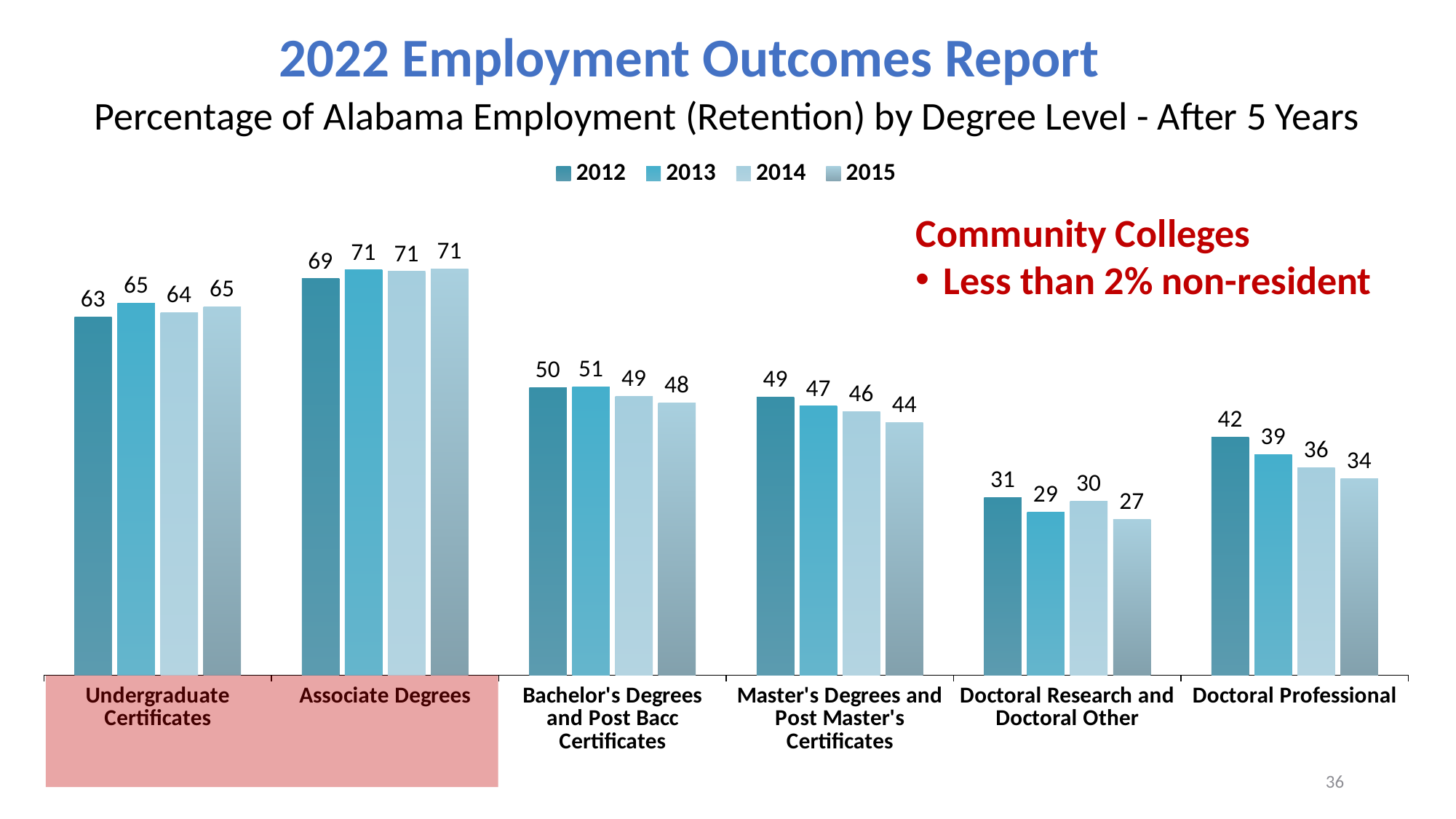
What is the 2015 value for Doctoral Research and Doctoral Other? 27 What kind of chart is shown on the slide? Bar chart What is the 2014 value for Bachelor's Degrees and Post Bacc Certificates? 49 How many degree-level categories are shown on the x axis? 6 Do the values for Doctoral Professional rise or fall from 2012 to 2015? Fall What is the 2012 value for Associate Degrees? 69 How many series does the legend list? 4 Which two categories are highlighted with a red/pink background on the x axis? Undergraduate Certificates and Associate Degrees What is the difference between the 2012 and 2015 values for Doctoral Professional? 8 Which is larger for Master's Degrees and Post Master's Certificates: the 2012 value or the 2015 value? 2012 Which degree level has the lowest 2015 value? Doctoral Research and Doctoral Other Which degree level has the highest 2013 value? Associate Degrees